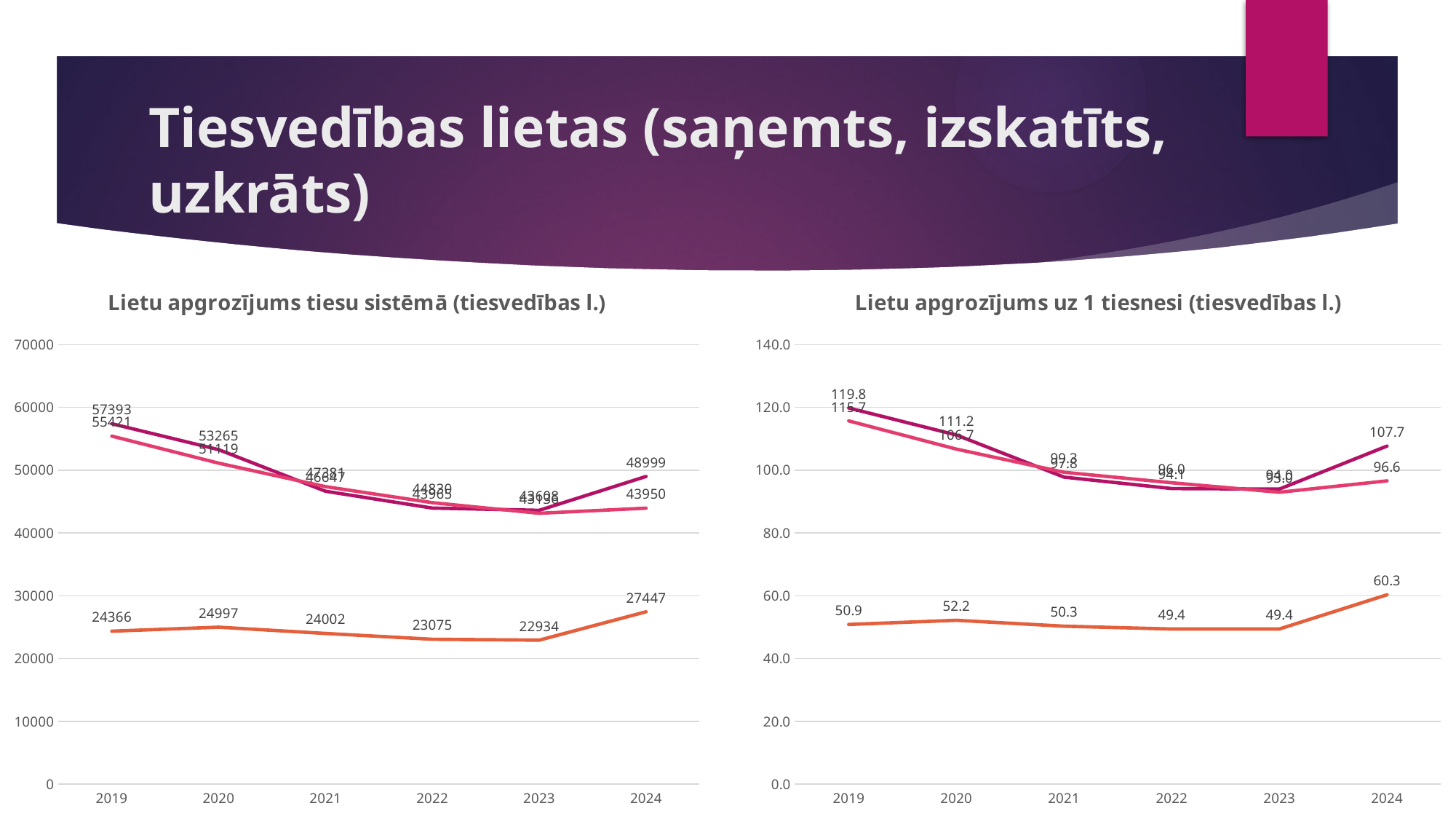
In the chart "Lietu apgrozījums tiesu sistēmā (tiesvedības l.)", is the value of the dark purple line in 2024 greater or less than 40000? greater What kind of chart is "Lietu apgrozījums tiesu sistēmā (tiesvedības l.)"? line chart In the chart "Lietu apgrozījums tiesu sistēmā (tiesvedības l.)", in which year is the orange line lowest? 2023 What is the title of the chart on the right side of the slide? Lietu apgrozījums uz 1 tiesnesi (tiesvedības l.) In the chart "Lietu apgrozījums uz 1 tiesnesi (tiesvedības l.)", which is larger in 2024: the dark purple line or the pink line? the dark purple line In the chart "Lietu apgrozījums tiesu sistēmā (tiesvedības l.)", what is the value of the dark purple line in 2019? 57393 In the chart "Lietu apgrozījums uz 1 tiesnesi (tiesvedības l.)", does the dark purple line rise or fall from 2019 to 2020? fall In the chart "Lietu apgrozījums tiesu sistēmā (tiesvedības l.)", how many years are shown on the x axis? 6 In the chart "Lietu apgrozījums uz 1 tiesnesi (tiesvedības l.)", in which year is the dark purple line highest? 2019 In the chart "Lietu apgrozījums tiesu sistēmā (tiesvedības l.)", what is the value of the orange line in 2024? 27447 In the chart "Lietu apgrozījums uz 1 tiesnesi (tiesvedības l.)", what is the value of the orange line in 2024? 60.3 In the chart "Lietu apgrozījums tiesu sistēmā (tiesvedības l.)", what is the difference between the orange line's values in 2024 and 2023? 4513